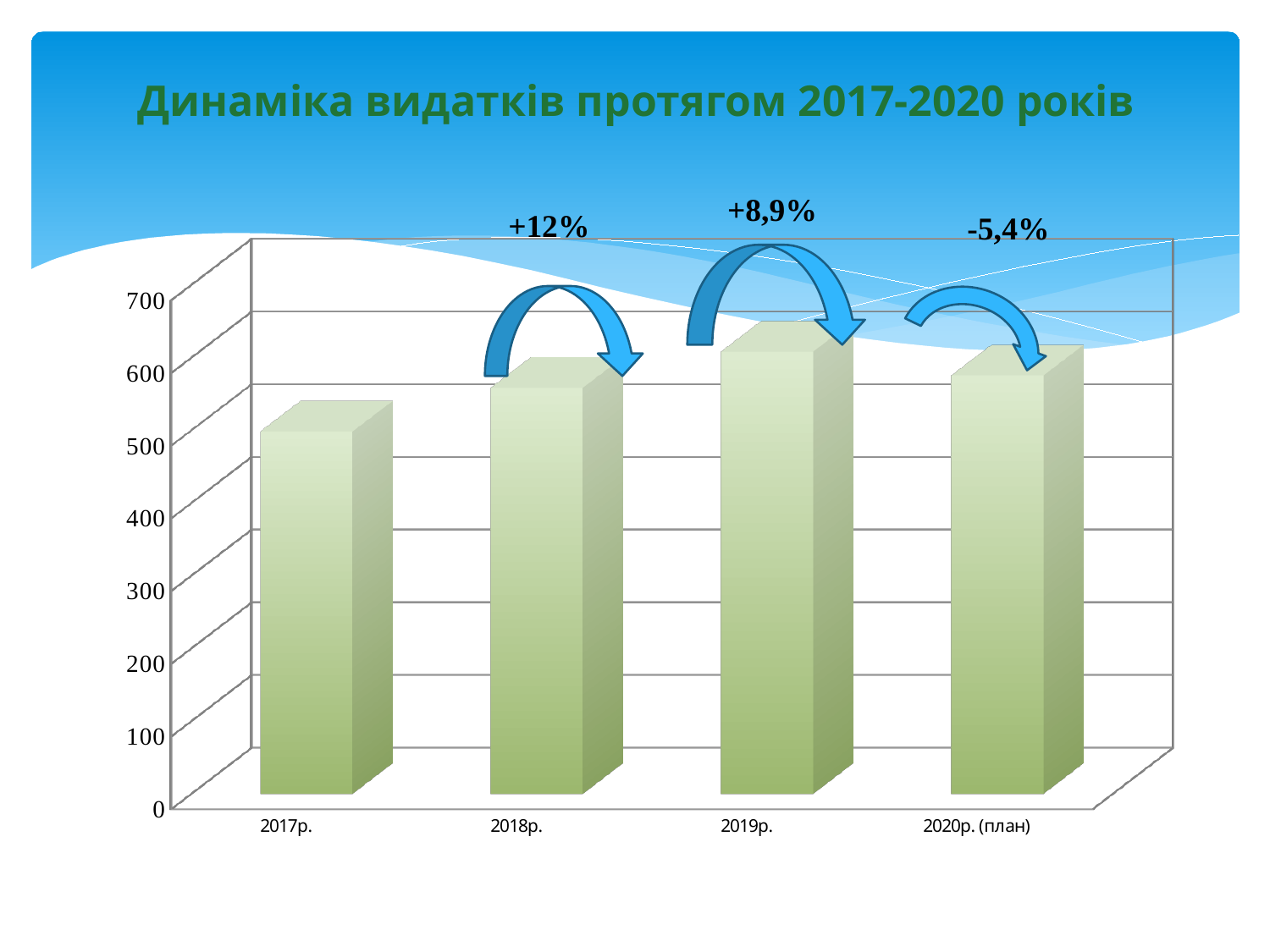
Is the value for 2017р. greater or less than 600? less Which year has the lowest bar in the chart? 2017р. Which is larger, the value for 2017р. or the value for 2019р.? 2019р. What type of chart is shown on the slide? bar chart What percentage change is annotated between 2017р. and 2018р.? +12% Which year has the highest bar in the chart? 2019р. Is the value for 2018р. greater or less than 500? greater What is the title of the chart on the slide? Динаміка видатків протягом 2017-2020 років What percentage change is annotated between 2019р. and 2020р. (план)? -5,4% Is the value for 2020р. (план) greater or less than 700? less How many categories (years) are shown on the x axis of the chart? 4